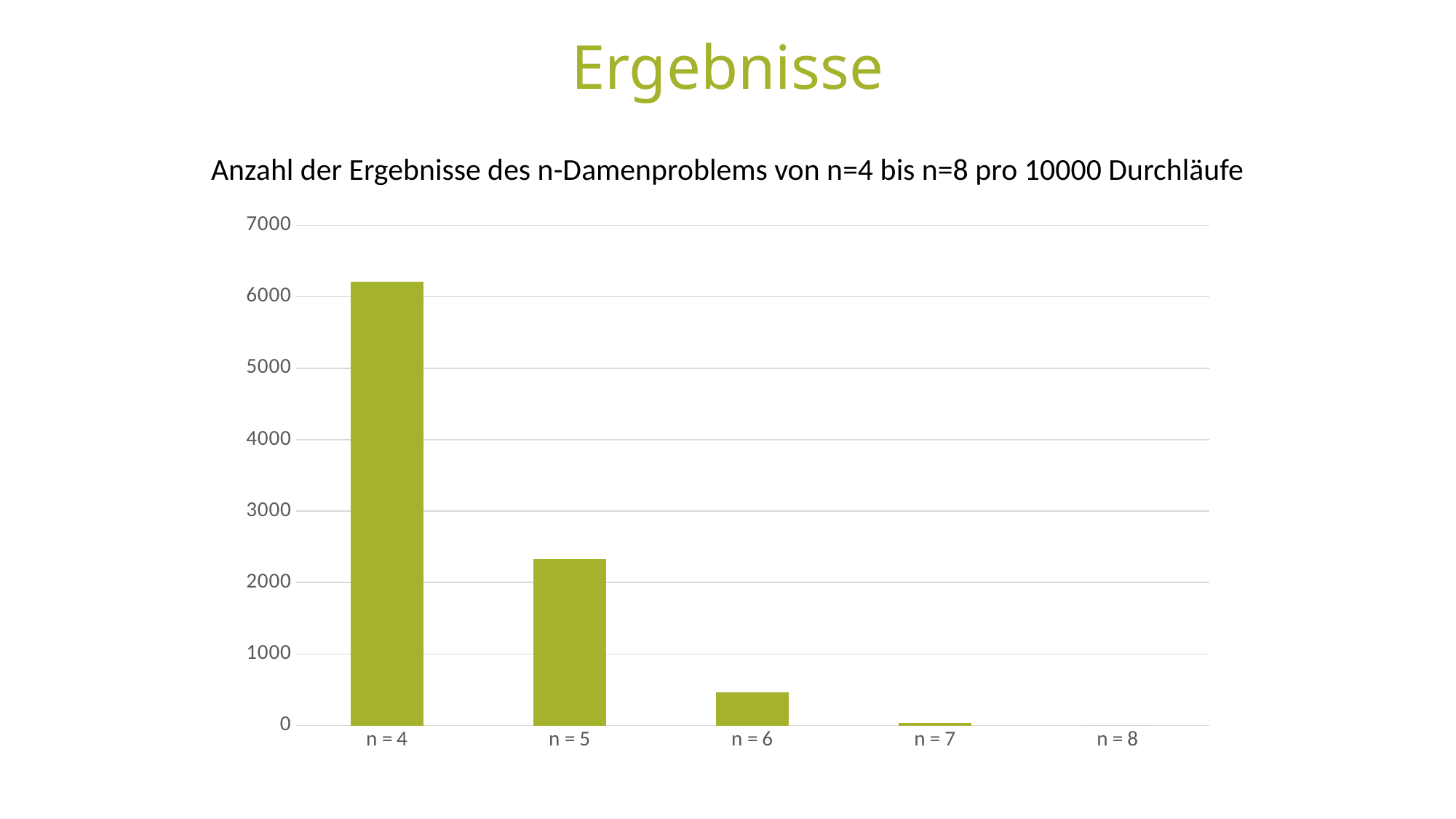
Which category has the highest value in the chart? n = 4 Is the value for n = 4 greater or less than 6000? greater Which category has the lowest value in the chart? n = 8 Is the value for n = 7 greater or less than 1000? less Which is larger, the value for n = 5 or the value for n = 6? n = 5 Do the values rise or fall as n increases from n = 4 to n = 8? fall What is the highest value shown on the y axis of the chart? 7000 Is the value for n = 5 greater or less than 2000? greater How many categories are shown on the x axis of the chart? 5 What is the title of the chart? Anzahl der Ergebnisse des n-Damenproblems von n=4 bis n=8 pro 10000 Durchläufe What kind of chart is shown on the slide? bar chart